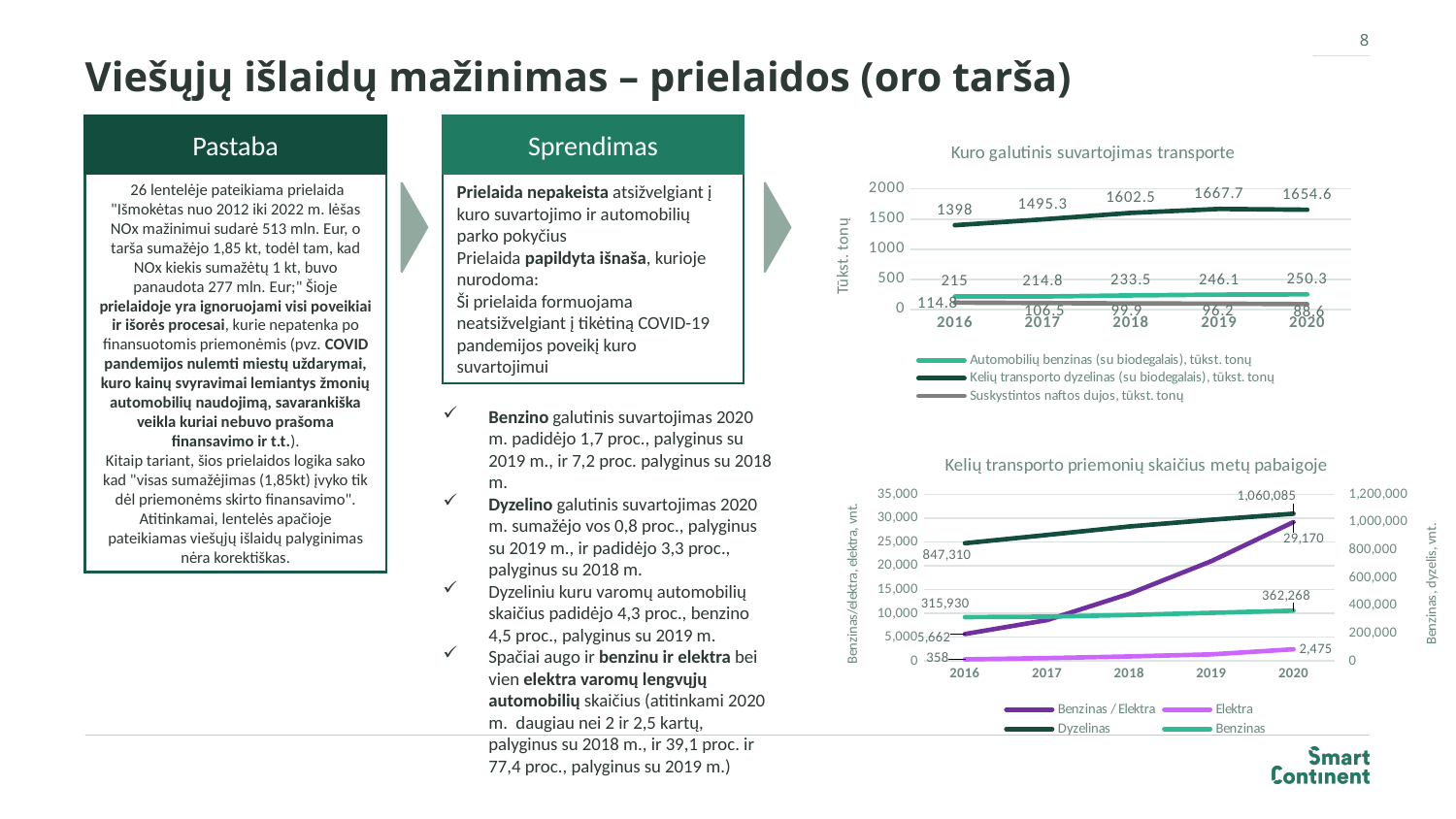
What type of chart is 'Kelių transporto priemonių skaičius metų pabaigoje'? line chart How many series does the legend of the chart 'Kuro galutinis suvartojimas transporte' list? 3 How many years are shown on the x axis of the chart 'Kelių transporto priemonių skaičius metų pabaigoje'? 5 In the chart 'Kuro galutinis suvartojimas transporte', what is the value for Kelių transporto dyzelinas in 2019? 1667.7 In the chart 'Kuro galutinis suvartojimas transporte', does the Suskystintos naftos dujos series rise or fall from 2016 to 2020? fall In the chart 'Kuro galutinis suvartojimas transporte', what is the value for Suskystintos naftos dujos in 2016? 114.8 In the chart 'Kelių transporto priemonių skaičius metų pabaigoje', what is the value for Dyzelinas in 2020? 1,060,085 In the chart 'Kuro galutinis suvartojimas transporte', what is the value for Automobilių benzinas in 2020? 250.3 In the chart 'Kelių transporto priemonių skaičius metų pabaigoje', which is larger in 2020: Benzinas / Elektra or Elektra? Benzinas / Elektra In the chart 'Kuro galutinis suvartojimas transporte', what is the difference between the Automobilių benzinas values in 2020 and 2016? 35.3 In the chart 'Kelių transporto priemonių skaičius metų pabaigoje', what is the value for Elektra in 2016? 358 In the chart 'Kuro galutinis suvartojimas transporte', in which year is the Kelių transporto dyzelinas value highest? 2019